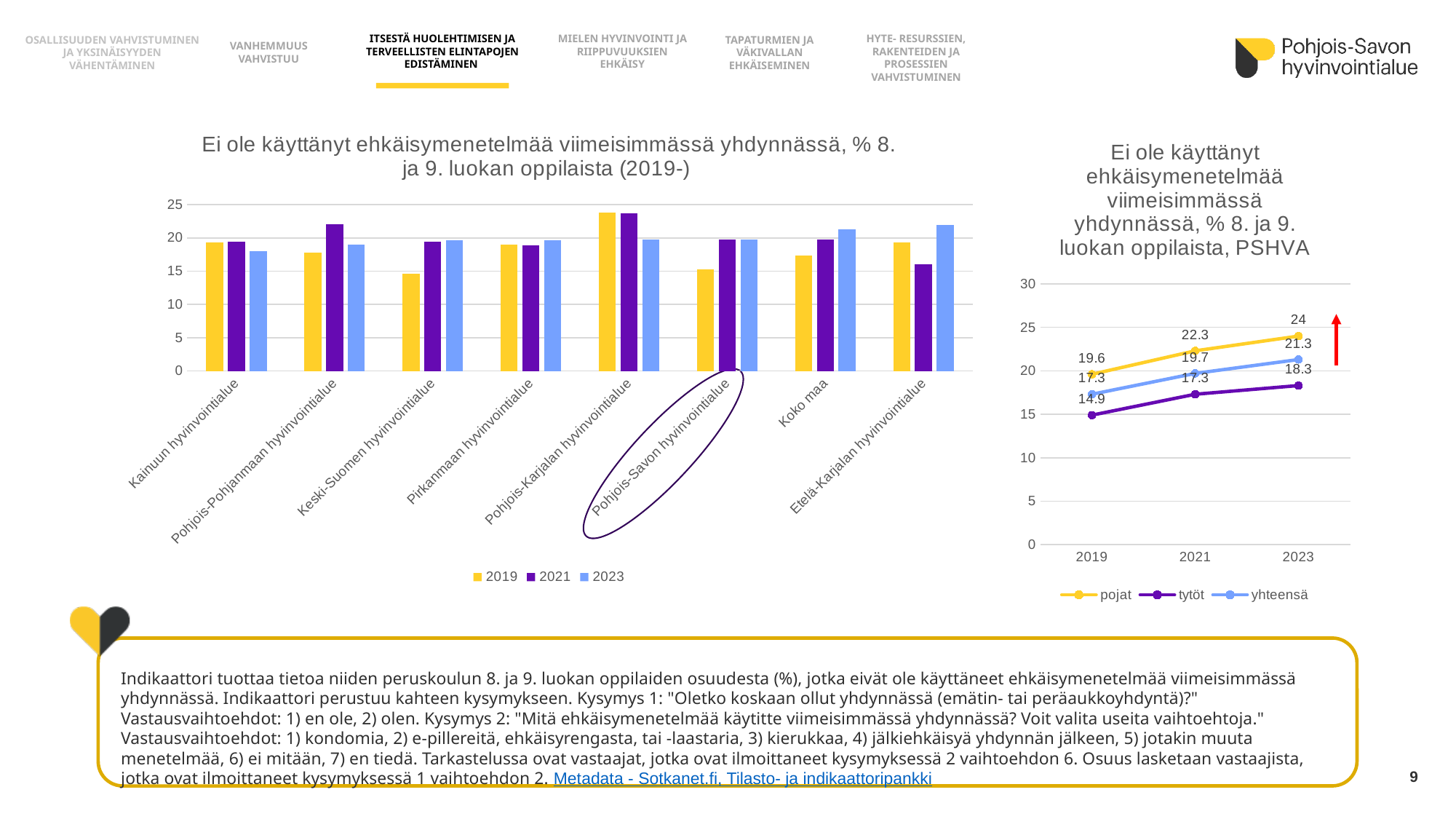
In the right chart (PSHVA), does the value for tytöt rise or fall from 2019 to 2023? rise In the right chart (PSHVA), what is the value for tytöt in 2019? 14.9 In the left chart, is the 2019 value for Pohjois-Karjalan hyvinvointialue greater or less than 20? greater In the right chart (PSHVA), what is the difference between pojat and tytöt in 2023? 5.7 What kind of chart is the left chart (Ei ole käyttänyt ehkäisymenetelmää ... (2019-))? bar chart In the right chart (PSHVA), how many series does the legend list? 3 In the right chart (PSHVA), what is the value for pojat in 2023? 24 In the right chart (PSHVA), what is the value for yhteensä in 2021? 19.7 In the right chart (PSHVA), which series has the highest value in 2023? pojat In the left chart, how many regions (categories) are shown on the x axis? 8 What kind of chart is the right chart (PSHVA)? line chart